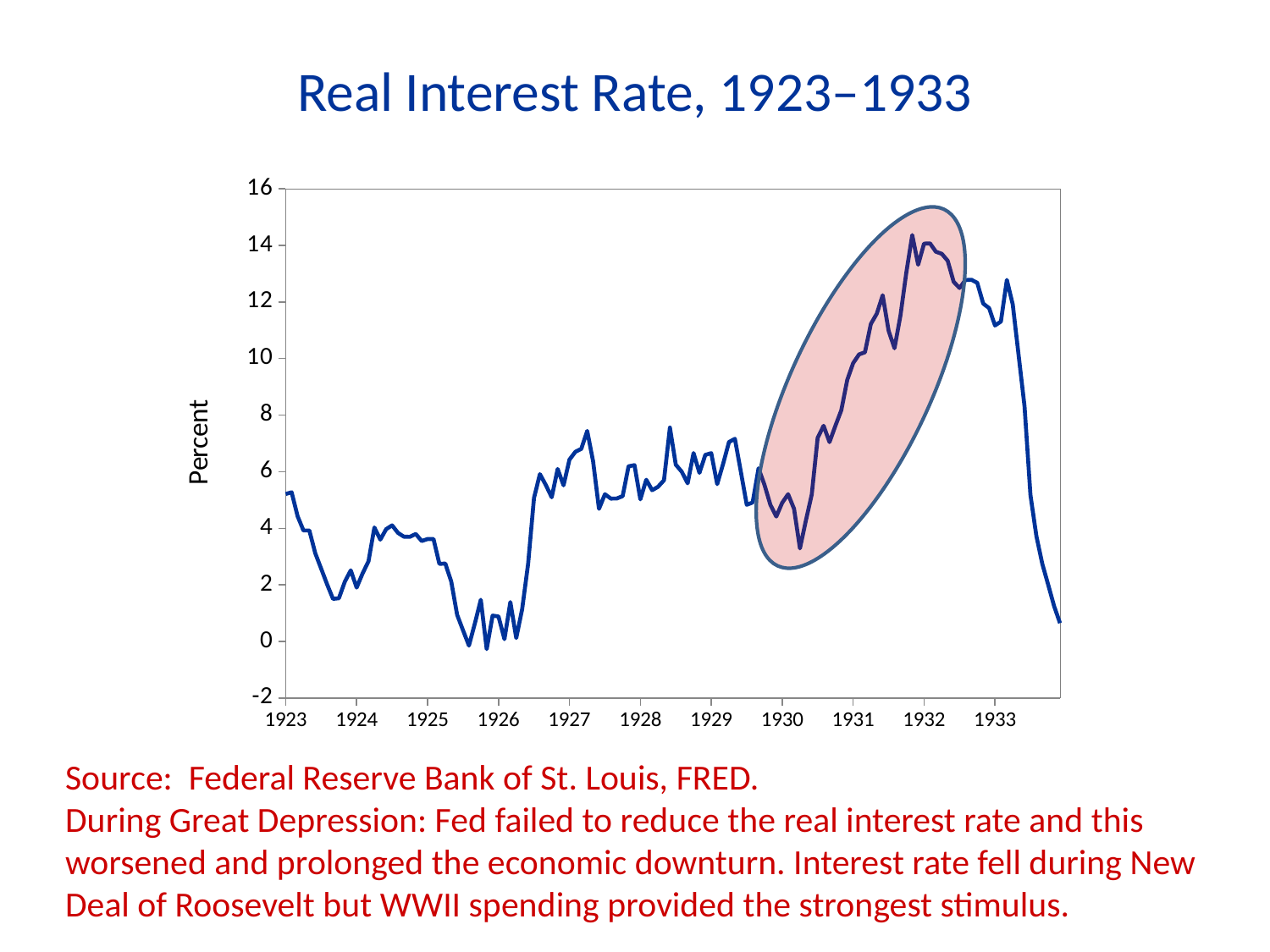
Is the real interest rate at the start of 1930 greater or less than 4? greater Is the real interest rate at the start of 1923 greater or less than 4? greater What is the title of the chart? Real Interest Rate, 1923–1933 Is the highest value reached by the real interest rate greater or less than 12? greater What kind of chart is shown on the slide? line chart Does the real interest rate rise or fall over the course of 1933? fall What is the label on the vertical axis of the chart? Percent Does the real interest rate generally rise or fall between 1930 and 1932? rise How many year labels are shown along the x axis? 11 In which year does the real interest rate reach its highest point? 1931